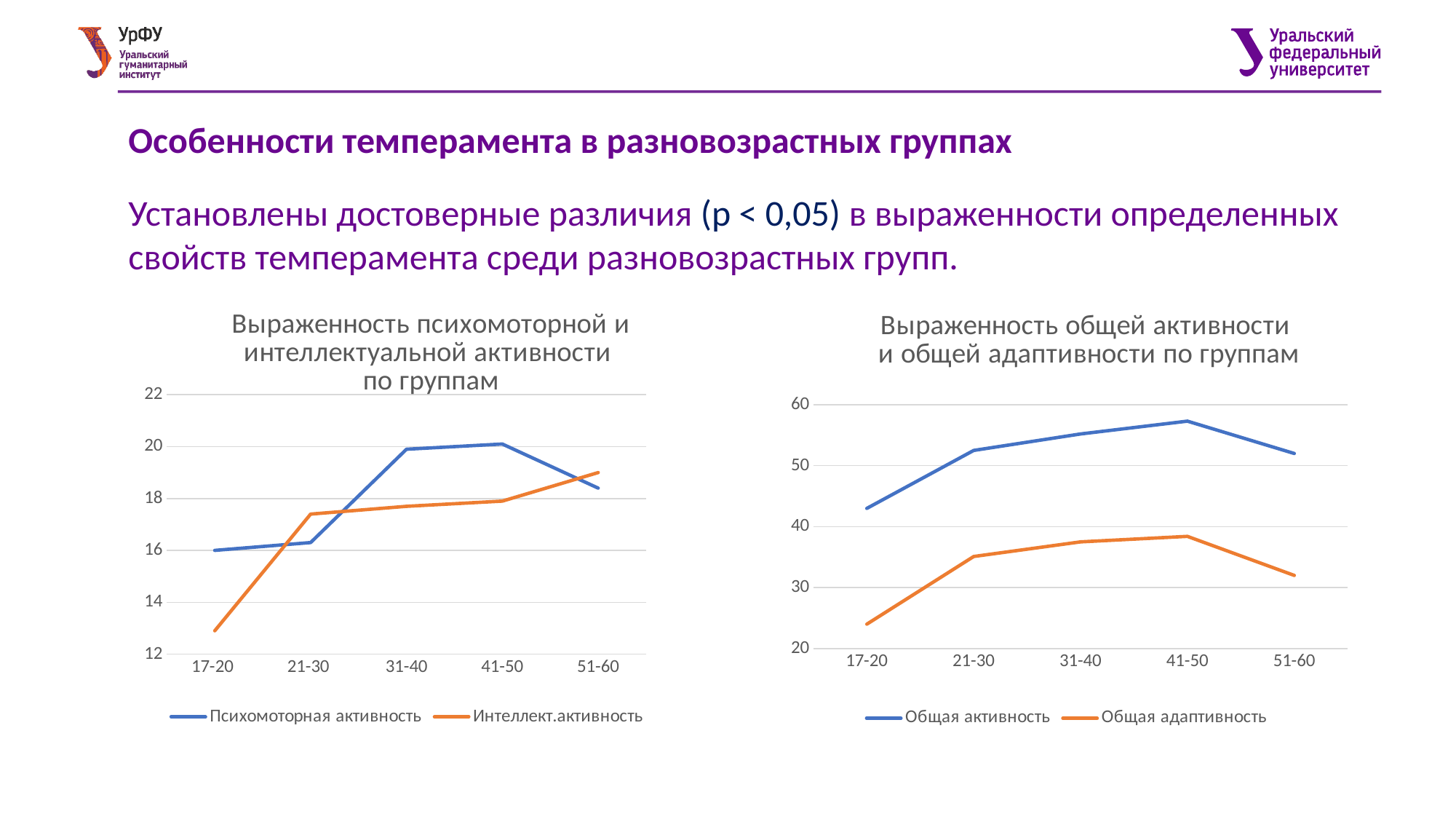
In the right chart, does Общая адаптивность rise or fall from the 17-20 group to the 21-30 group? rise In the left chart, is the value of Психомоторная активность for the 31-40 group greater or less than 18? greater How many series does the legend of the left chart list? 2 What kind of chart is the left chart, 'Выраженность психомоторной и интеллектуальной активности по группам'? line chart In the right chart, which series has the larger value for the 31-40 group, Общая активность or Общая адаптивность? Общая активность In the left chart, which age group has the highest value of Интеллект.активность? 51-60 In the right chart, which age group has the highest value of Общая активность? 41-50 In the right chart, is the value of Общая активность for the 17-20 group greater or less than 40? greater In the right chart, is the value of Общая адаптивность for the 51-60 group greater or less than 30? greater In the left chart, which age group has the lowest value of Интеллект.активность? 17-20 How many age groups are shown on the x axis of the right chart, 'Выраженность общей активности и общей адаптивности по группам'? 5